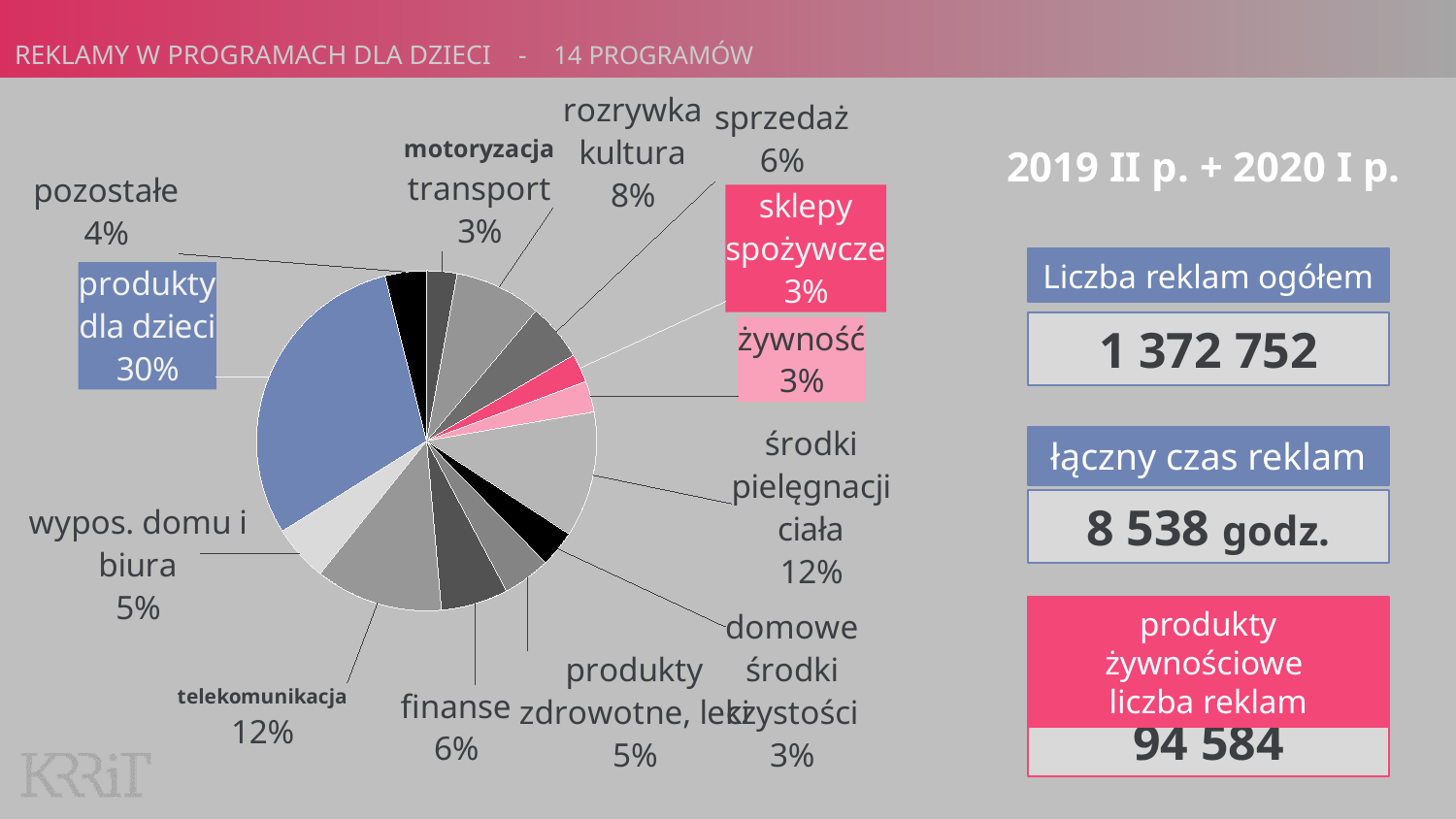
What type of chart is shown on the slide? pie chart What is the combined share of "żywność" and "sklepy spożywcze"? 6% What is the value shown for "finanse"? 6% What is the value shown for "telekomunikacja"? 12% What period does the chart cover, according to the heading on the right? 2019 II p. + 2020 I p. What is the difference between the shares of "produkty dla dzieci" and "środki pielęgnacji ciała"? 18 percentage points What is the value shown for "rozrywka kultura"? 8% How many categories are shown in the pie chart? 13 What is the value shown for "wypos. domu i biura"? 5% Which is larger, the share for "sprzedaż" or the share for "pozostałe"? sprzedaż Which category has the largest share of the pie? produkty dla dzieci What share of the pie does "produkty dla dzieci" have? 30%